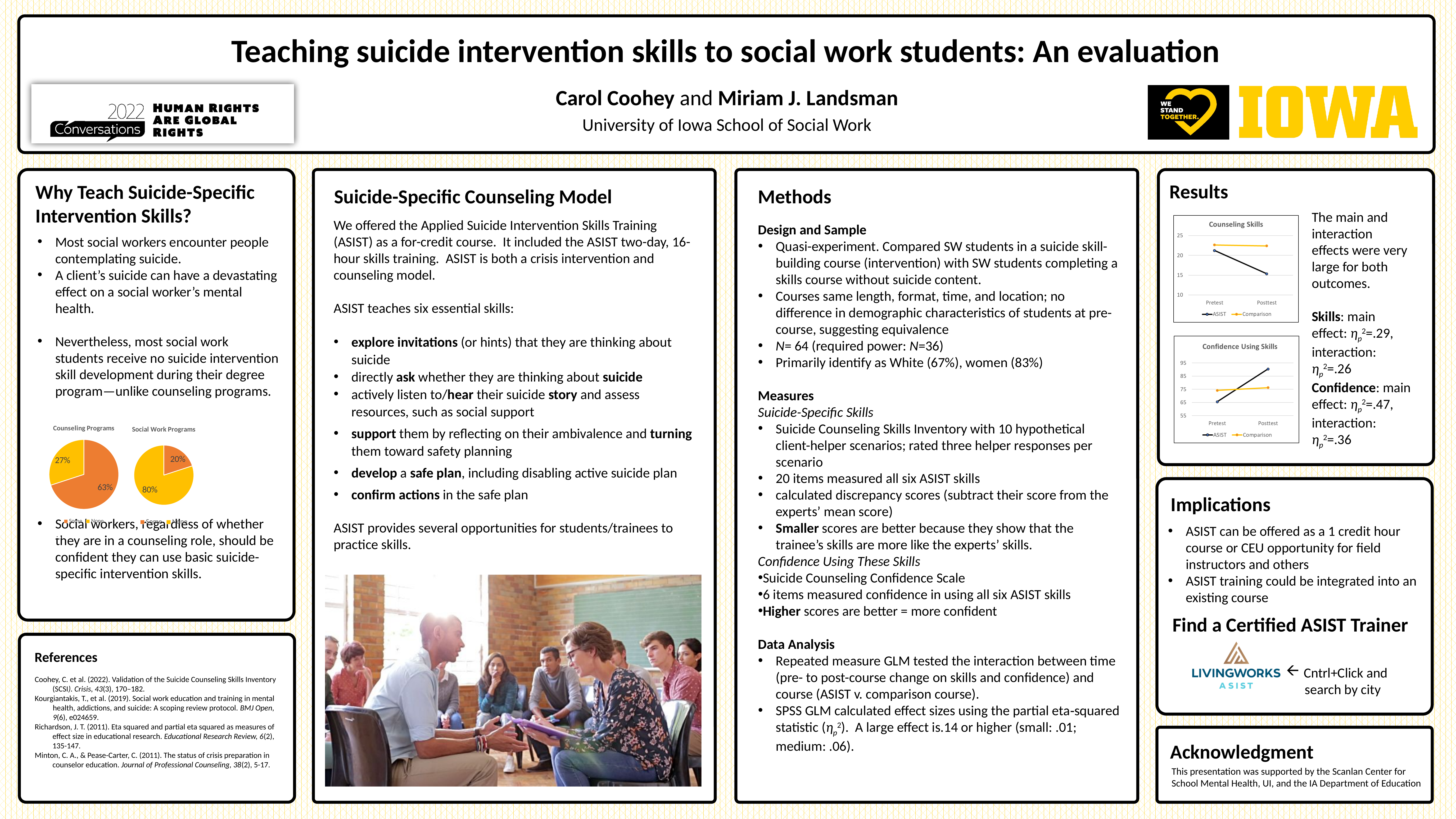
What are the two series named in the legend of the "Counseling Skills" chart? ASIST and Comparison In the "Counseling Skills" chart, does the ASIST series rise or fall from Pretest to Posttest? fall What kind of chart is the "Social Work Programs" chart? pie chart In the "Social Work Programs" pie chart, what is the larger slice's share? 80% In the "Confidence Using Skills" chart, does the ASIST series rise or fall from Pretest to Posttest? rise In the "Confidence Using Skills" chart, is the ASIST Posttest value greater or less than 85? greater How many series does the legend of the "Confidence Using Skills" chart list? 2 In the "Counseling Skills" chart, which series has the higher value at Posttest, ASIST or Comparison? Comparison What kind of chart is the "Counseling Skills" chart in the Results section? line chart How many time points are shown on the x axis of the "Confidence Using Skills" chart? 2 In the "Counseling Skills" chart, is the ASIST Posttest value greater or less than 20? less In the "Counseling Programs" pie chart, what share is shown for the smaller slice? 27%